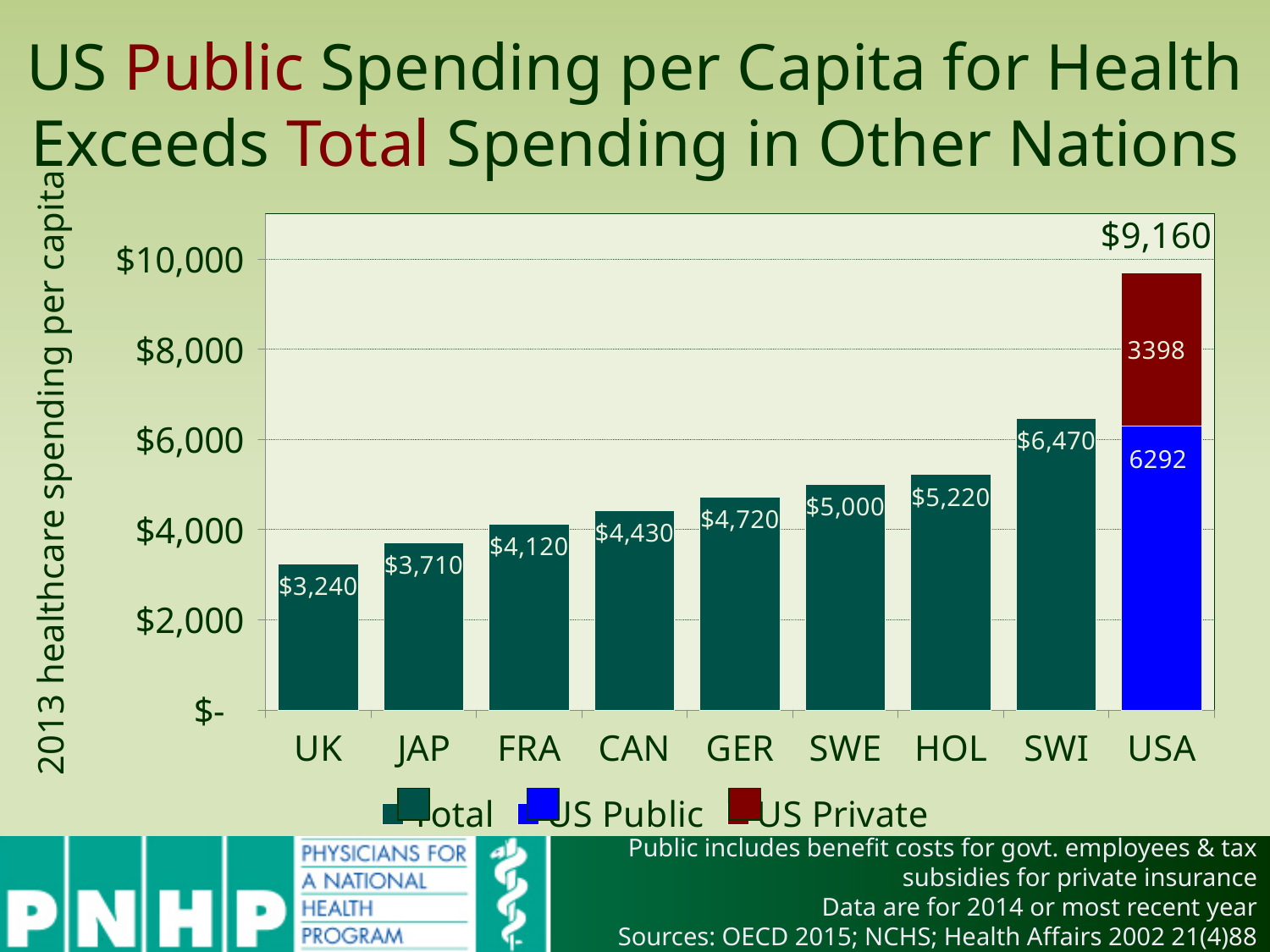
Which country has the highest healthcare spending per capita? USA What kind of chart is shown on the slide? bar chart Is the value for JAP greater or less than $4,000? less Which has higher healthcare spending per capita, GER or CAN? GER What is the US Public spending per capita shown on the USA bar? 6292 What is the total spending per capita for SWI? $6,470 What is the total healthcare spending per capita for the UK? $3,240 How many countries are shown on the x axis? 9 Which country has the lowest healthcare spending per capita? UK What is the difference between the total spending per capita for SWI and HOL? $1,250 How many series does the legend list? 3 What is the US Private spending per capita shown on the USA bar? 3398